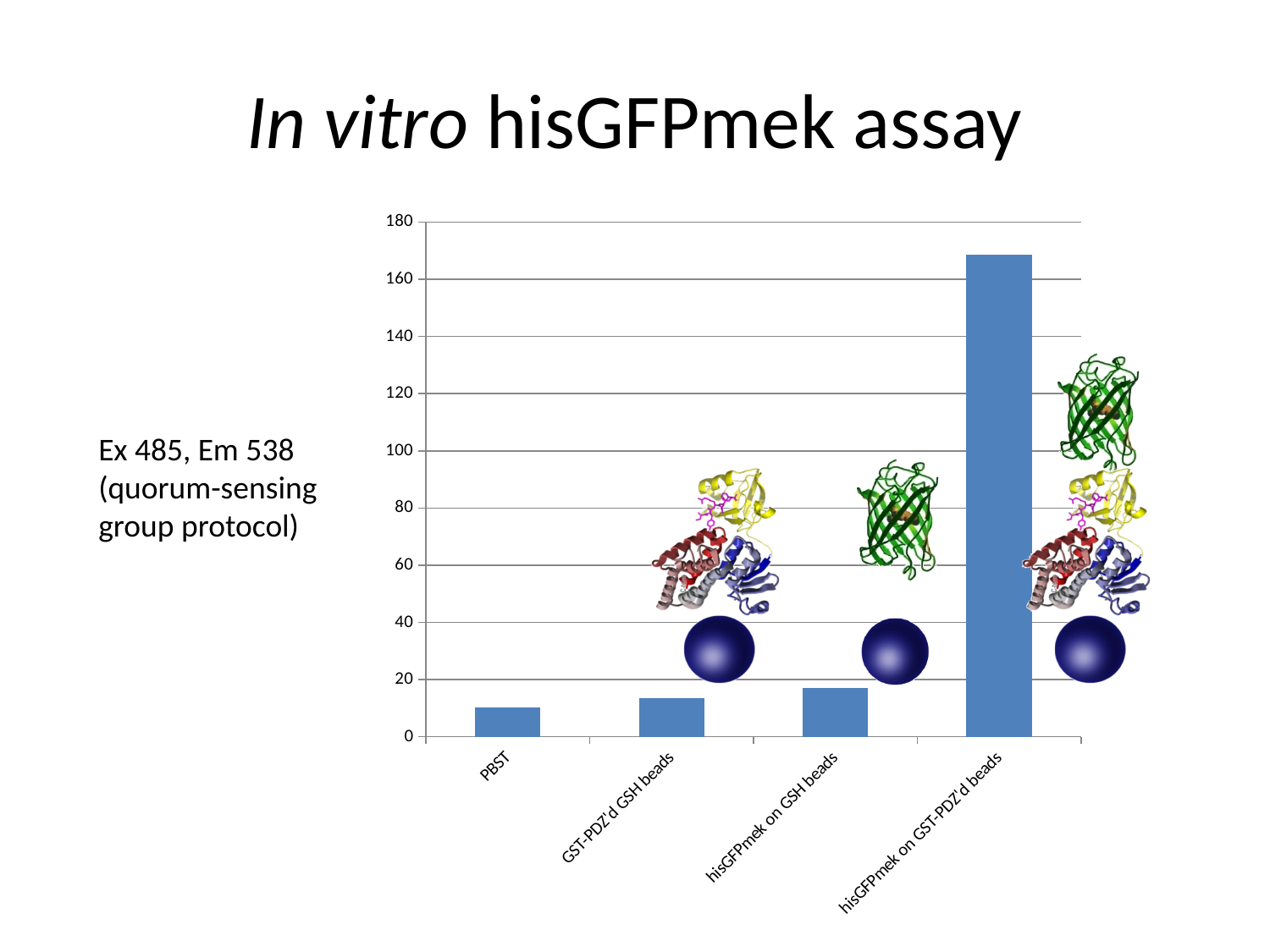
What kind of chart is shown on the slide? bar chart Is the value for hisGFPmek on GST-PDZ'd beads greater or less than 160? greater How many categories are plotted on the x axis of the chart? 4 Is the value for GST-PDZ'd GSH beads greater or less than 40? less Which is larger: the value for hisGFPmek on GSH beads or the value for PBST? hisGFPmek on GSH beads What is the highest tick value shown on the y axis of the chart? 180 Is the value for PBST greater or less than 20? less Do the bar values rise or fall from left to right along the x axis? rise What is the title of the slide containing the chart? In vitro hisGFPmek assay Which is larger: the value for hisGFPmek on GST-PDZ'd beads or the value for hisGFPmek on GSH beads? hisGFPmek on GST-PDZ'd beads Which category has the highest value in the chart? hisGFPmek on GST-PDZ'd beads